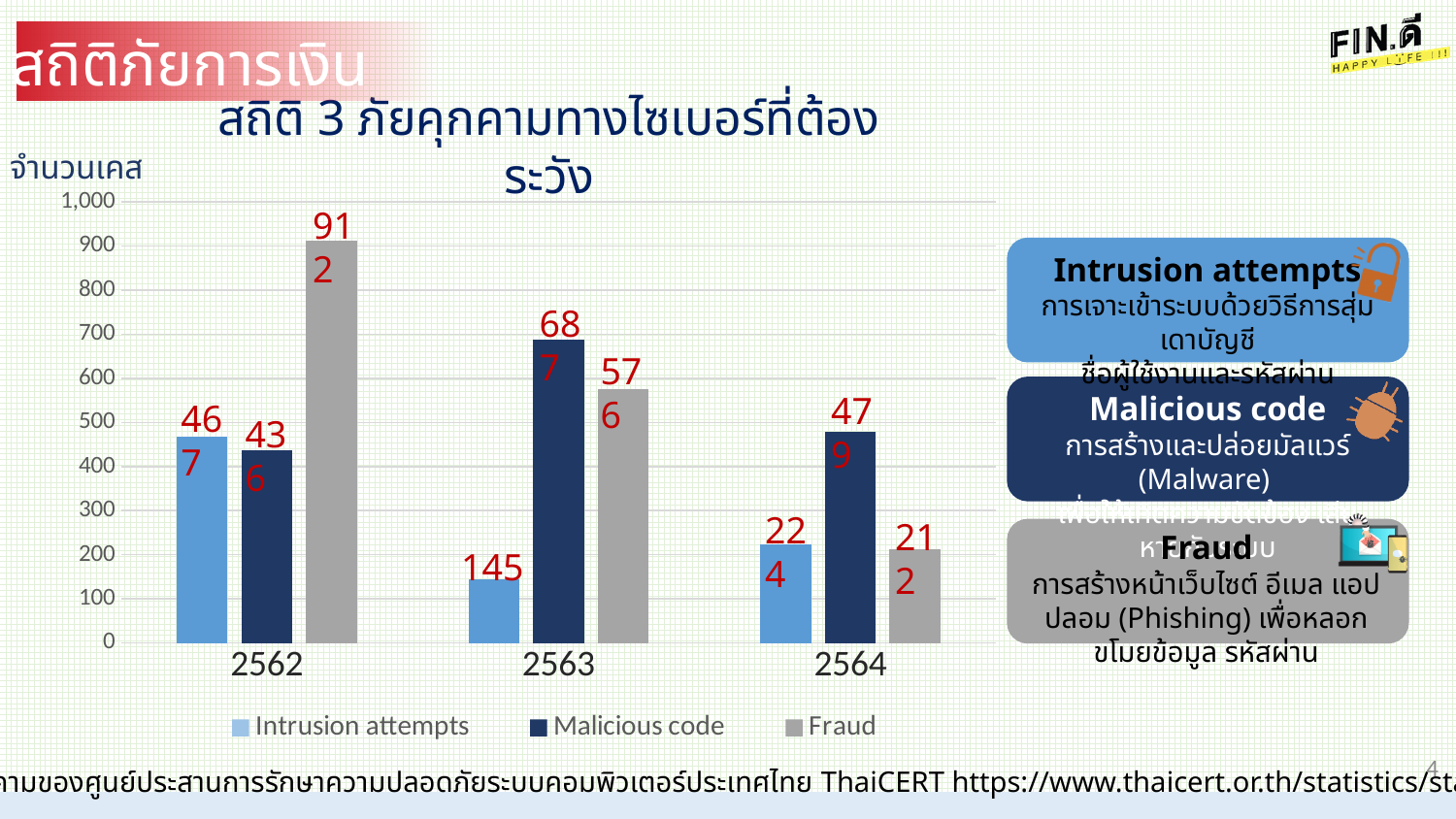
Which bar in the chart has the highest value? Fraud in 2562 Is the value for Malicious code in 2562 greater or less than 500? less What type of chart is shown on the slide? Bar chart Does the Fraud value rise or fall from 2562 to 2564? Fall Which bar in the chart has the lowest value? Intrusion attempts in 2563 In 2563, which is larger: Malicious code or Fraud? Malicious code What is the value for Fraud in 2562? 912 How many series does the chart legend list? 3 How many year categories are shown on the x axis of the chart? 3 What is the value for Intrusion attempts in 2563? 145 What is the difference between Malicious code and Intrusion attempts in 2564? 255 What is the value for Malicious code in 2564? 479